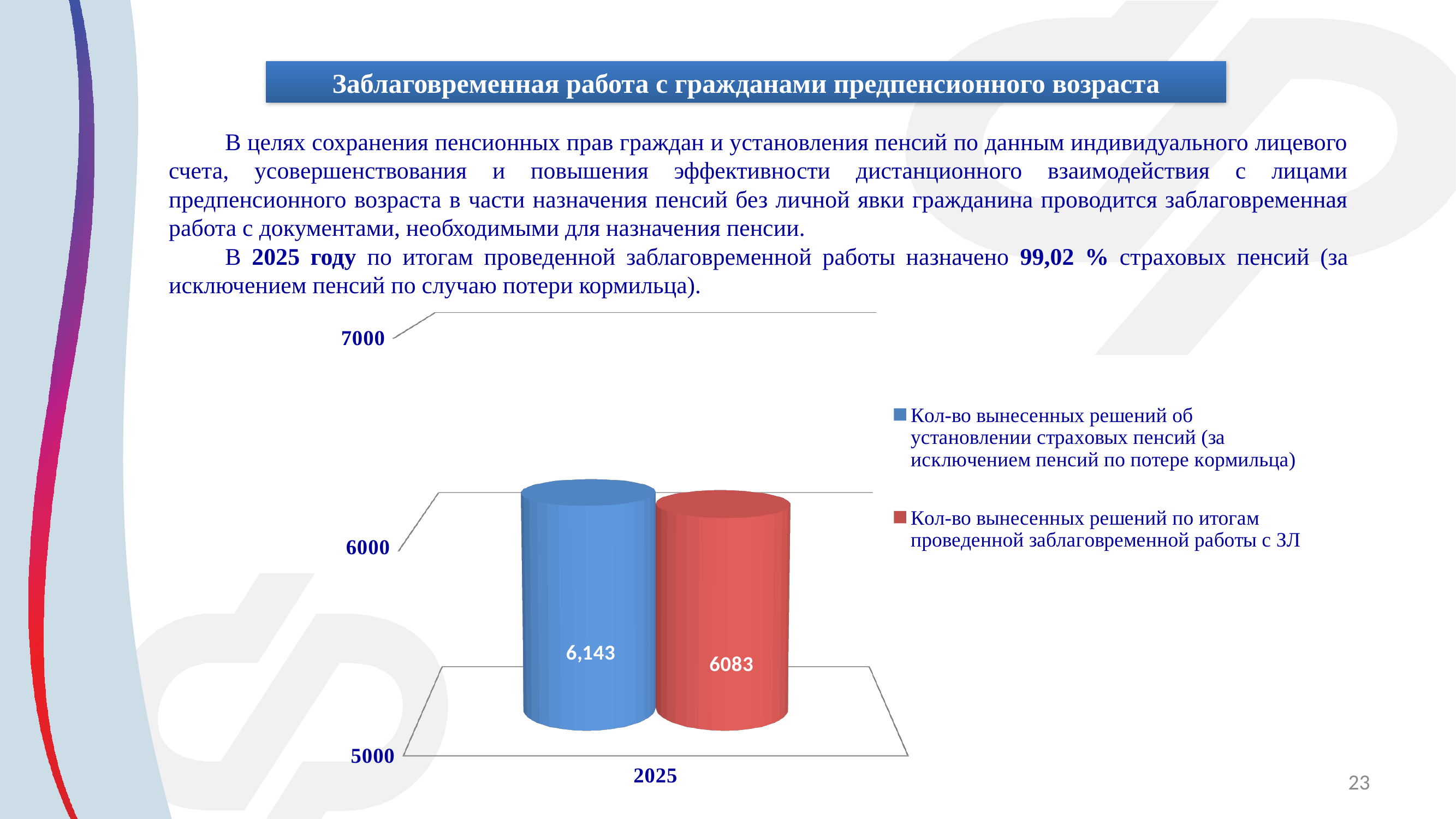
Which series has the lowest value in the chart? Кол-во вынесенных решений по итогам проведенной заблаговременной работы с ЗЛ What is the difference between the two values shown for 2025? 60 How many categories are shown on the x axis of the chart? 1 How many series does the chart legend list? 2 Is the value for 'Кол-во вынесенных решений об установлении страховых пенсий' greater or less than 7000? less What colour is the bar for 'Кол-во вынесенных решений по итогам проведенной заблаговременной работы с ЗЛ'? red Which series has the higher value in 2025: the number of decisions on establishing insurance pensions or the number of decisions following advance work with ЗЛ? Кол-во вынесенных решений об установлении страховых пенсий (за исключением пенсий по потере кормильца) What kind of chart is shown on the slide? bar chart What is the value for 'Кол-во вынесенных решений об установлении страховых пенсий (за исключением пенсий по потере кормильца)' in 2025? 6,143 What is the value for 'Кол-во вынесенных решений по итогам проведенной заблаговременной работы с ЗЛ' in 2025? 6083 Is the value for 'Кол-во вынесенных решений по итогам проведенной заблаговременной работы с ЗЛ' greater or less than 6000? greater Which year is shown on the x axis of the chart? 2025